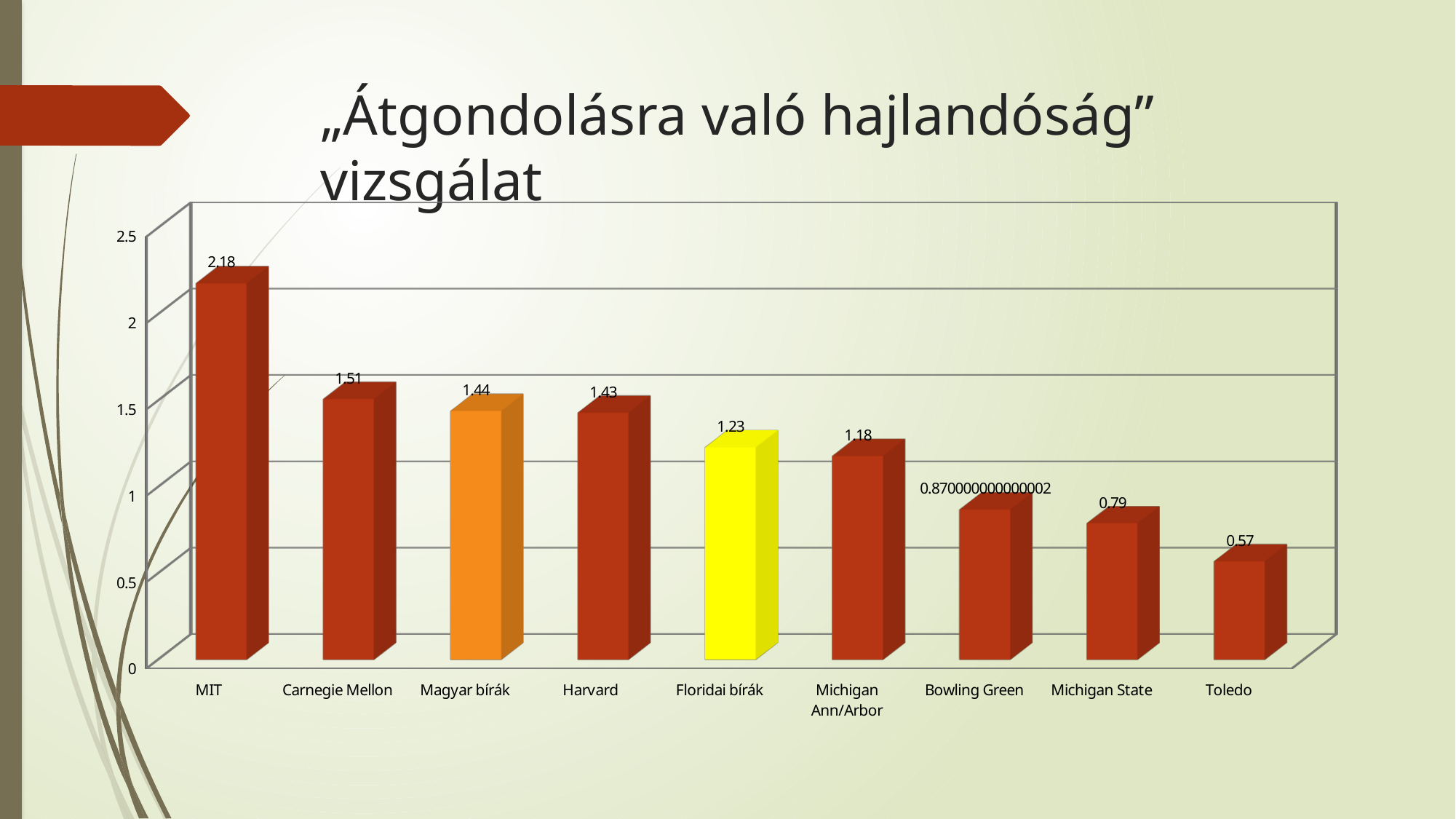
Which category has the lowest value? Toledo What value is shown for MIT? 2.18 What value is shown for Michigan State? 0.79 What is the data label shown above the Bowling Green bar? 0.870000000000002 What value is shown for Floridai bírák? 1.23 What kind of chart is shown on the slide? Bar chart How many categories are shown on the x axis? 9 Which category has the highest value? MIT What is the difference between the values for Magyar bírák and Floridai bírák? 0.21 Do the values rise or fall from left to right along the x axis? Fall What is the difference between the values for MIT and Toledo? 1.61 Which is larger, the value for Harvard or the value for Michigan Ann/Arbor? Harvard